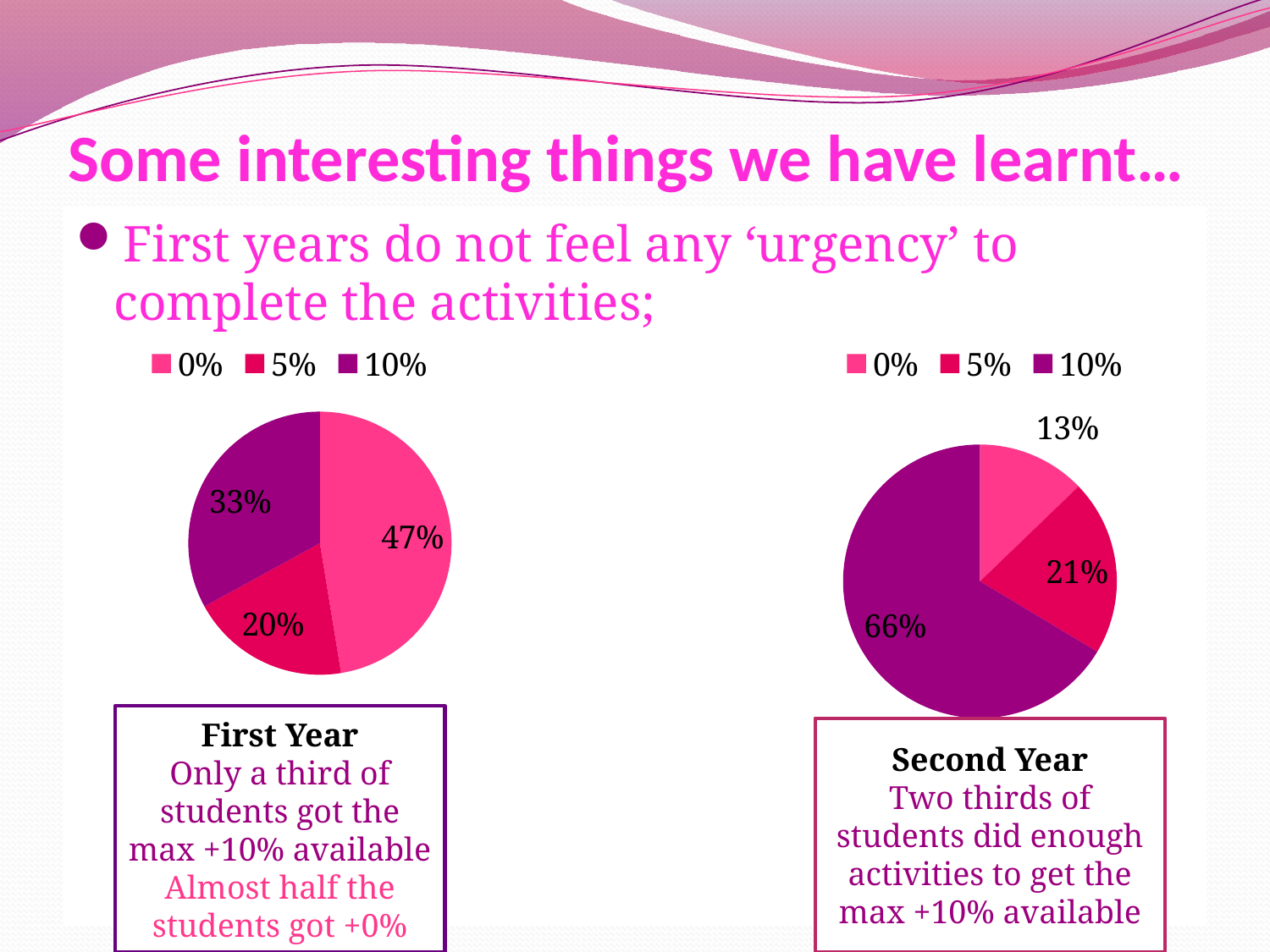
In the left pie chart (First Year), what is the difference between the 0% slice and the 10% slice? 14% In the left pie chart (First Year), what share of students got 10%? 33% How many entries does the legend of the left pie chart (First Year) list? 3 In the right pie chart (Second Year), what share of students got 0%? 13% In the right pie chart (Second Year), which category has the smallest slice? 0% In the left pie chart (First Year), what share of students got 0%? 47% How many slices does the right pie chart (Second Year) have? 3 In the left pie chart (First Year), which category has the largest slice? 0% In the right pie chart (Second Year), what is the difference between the 10% slice and the 5% slice? 45% In the right pie chart (Second Year), what share of students got 10%? 66% Is the 5% slice larger in the left pie chart (First Year) or the right pie chart (Second Year)? Right pie chart (Second Year) What type of chart is used on the left for First Year? Pie chart